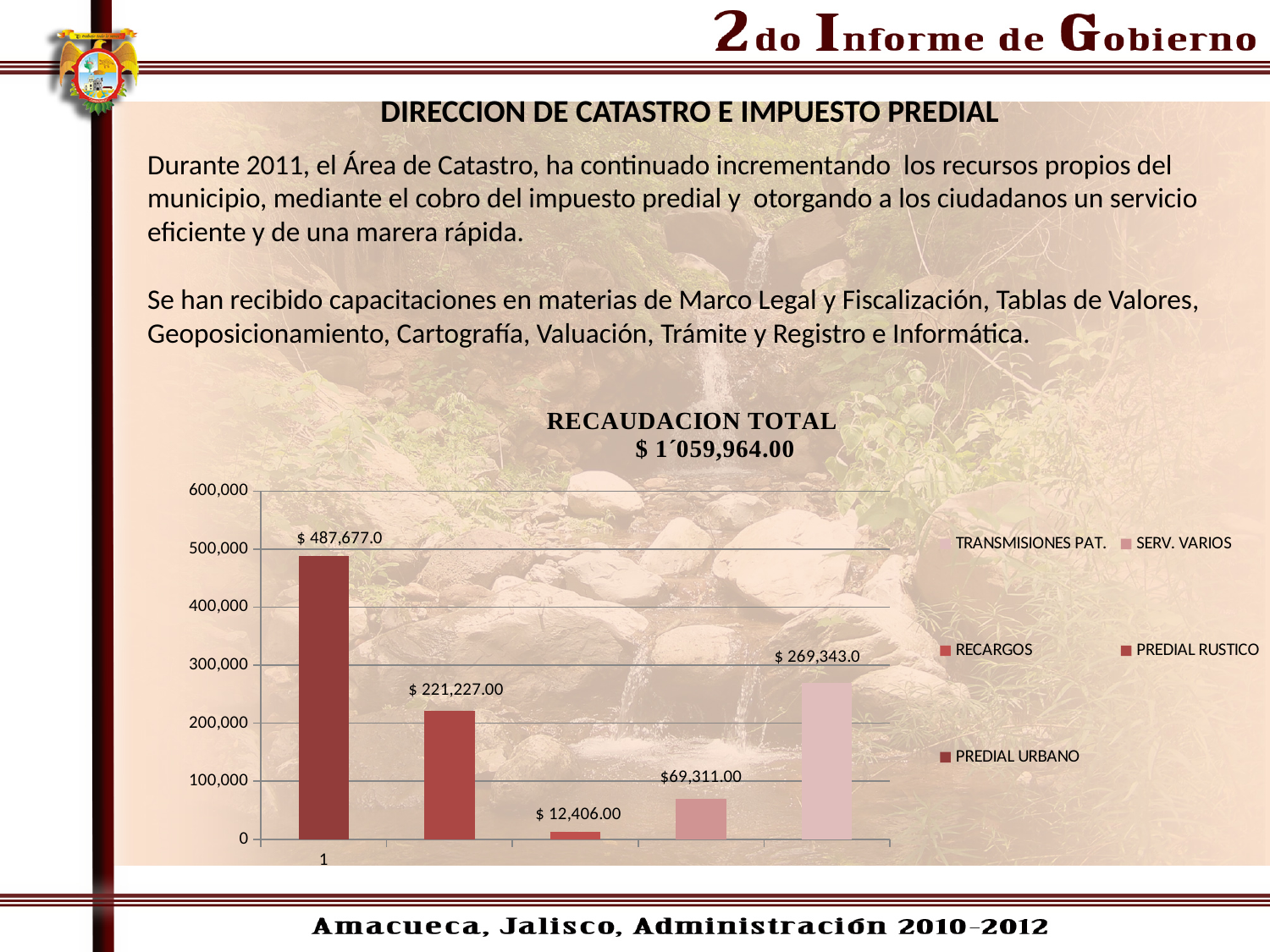
What kind of chart is shown on the slide? Bar chart What is the value shown for RECARGOS? $ 12,406.00 What is the value shown for SERV. VARIOS? $69,311.00 What total amount is stated in the chart title? $ 1´059,964.00 What is the value shown for TRANSMISIONES PAT.? $ 269,343.0 What is the difference between PREDIAL URBANO and PREDIAL RUSTICO? 266,450.00 What is the value shown for PREDIAL URBANO? $ 487,677.0 What is the value shown for PREDIAL RUSTICO? $ 221,227.00 Which series has the highest value? PREDIAL URBANO Which is larger, TRANSMISIONES PAT. or PREDIAL RUSTICO? TRANSMISIONES PAT. Which series has the lowest value? RECARGOS How many series does the legend list? 5